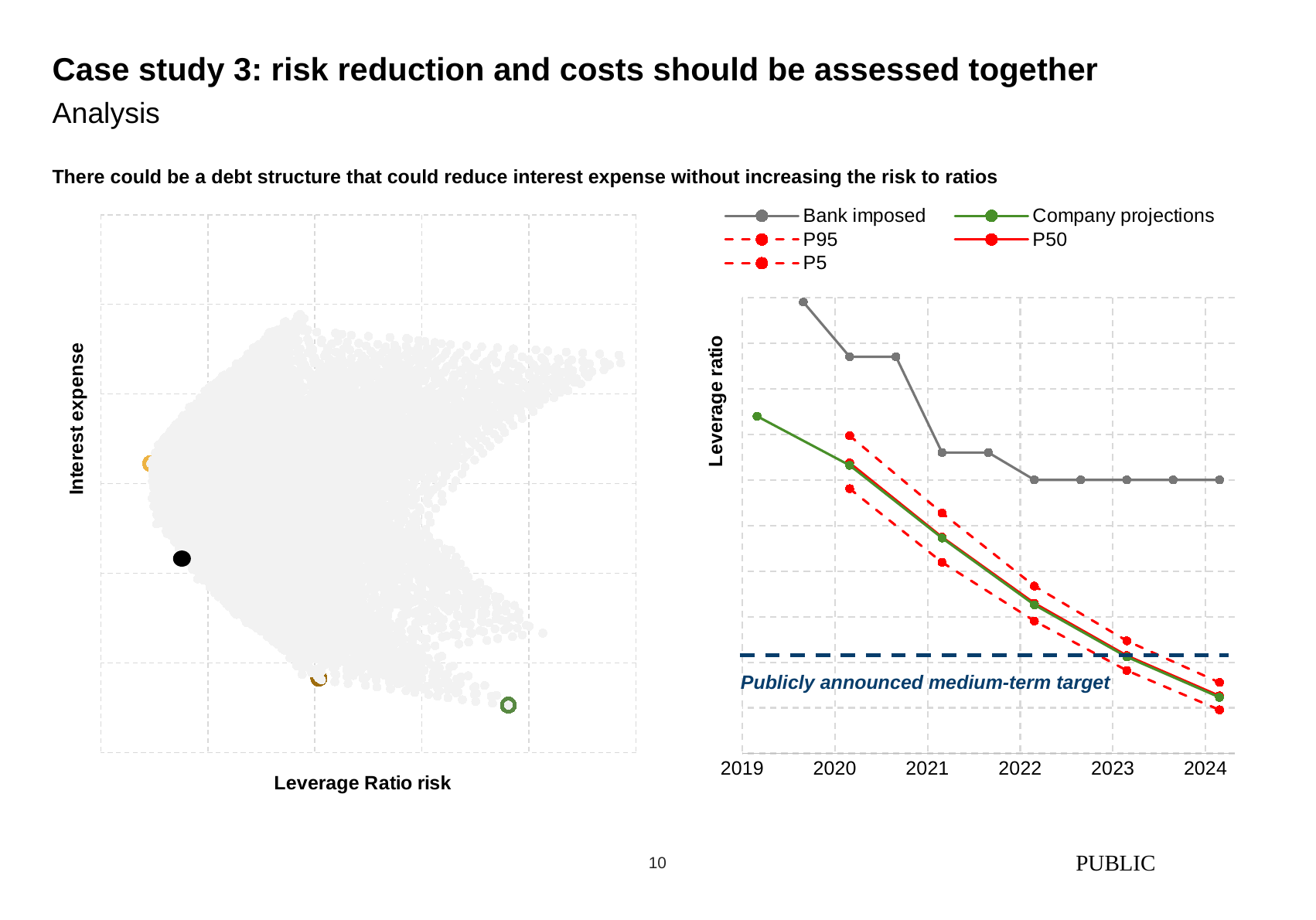
How many series does the legend of the right-hand chart list? 5 In the right-hand chart, which series has the highest leverage ratio values throughout the period? Bank imposed In the right-hand chart, does the Bank imposed series rise or fall over the years shown? fall What is the y-axis label of the right-hand chart? Leverage ratio What is the x-axis label of the left-hand chart? Leverage Ratio risk What kind of chart is the chart on the left of the slide? scatter plot What kind of chart is the chart on the right of the slide? line chart How many years are labelled on the x axis of the right-hand chart? 6 In the right-hand chart, does the Company projections series rise or fall from 2019 to 2024? fall In the right-hand chart, which series is higher in 2022: Bank imposed or Company projections? Bank imposed In the right-hand chart, which series is lower in 2024: P95 or P5? P5 In the right-hand chart, what does the dashed horizontal line represent? Publicly announced medium-term target